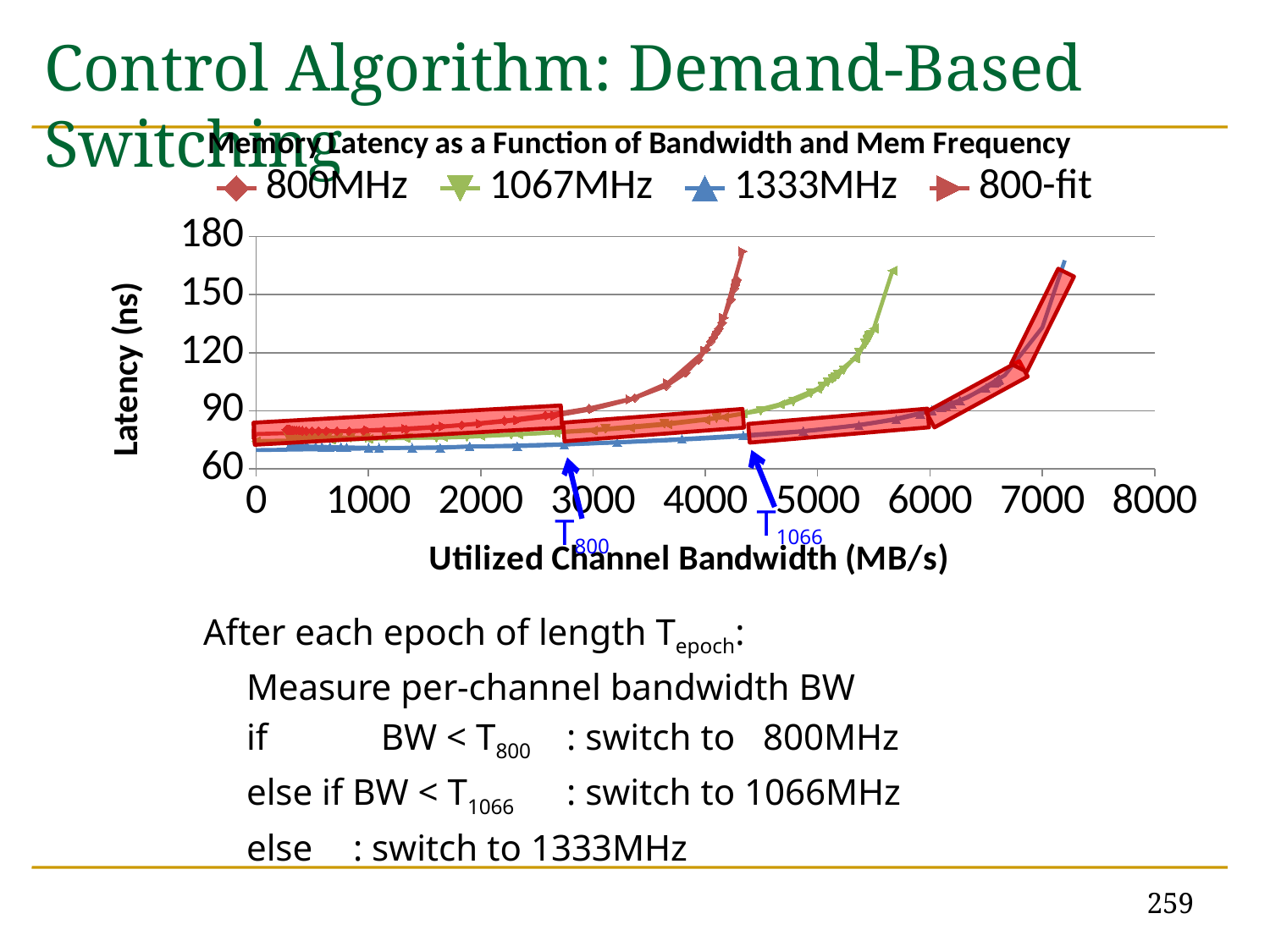
How many series does the chart legend list? 4 At 2000 MB/s, which series has the higher latency, 800MHz or 1333MHz? 800MHz Is the latency of the 1333MHz series at 0 MB/s greater or less than 90? less Which series has its latency spike at the lowest utilized channel bandwidth? 800MHz Is the latency of the 800MHz series at 1000 MB/s greater or less than 90? less Does latency rise or fall as utilized channel bandwidth increases along the x axis? rise What is the label of the chart's y axis? Latency (ns) Which series reaches the highest utilized channel bandwidth before its latency spikes? 1333MHz What kind of chart is shown on the slide? line chart Is the peak latency of the 1067MHz series greater or less than 150? greater What is the title of the chart? Memory Latency as a Function of Bandwidth and Mem Frequency